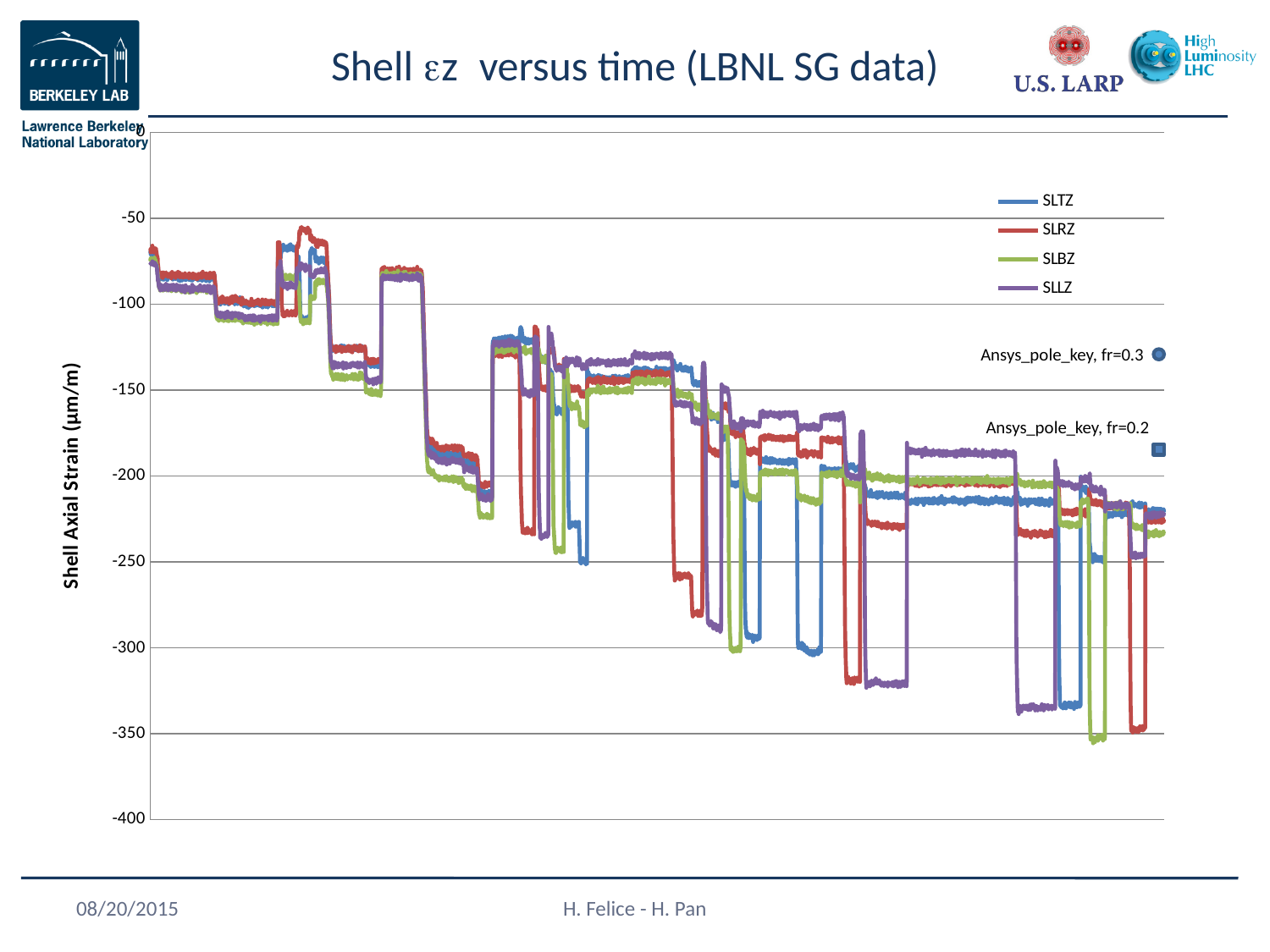
Is the lowest value reached by the SLLZ series greater or less than -300? less Is the lowest value reached by the SLTZ series greater or less than -300? less What is the label of the y axis? Shell Axial Strain (µm/m) Do the strain values generally rise or fall along the x axis over time? fall Is the value of the Ansys_pole_key, fr=0.3 marker greater or less than -150? greater Which series is drawn in red? SLRZ How many series does the legend list? 4 Which of the two Ansys_pole_key markers is plotted at a higher strain value, fr=0.3 or fr=0.2? fr=0.3 What kind of chart is shown on the slide? line chart